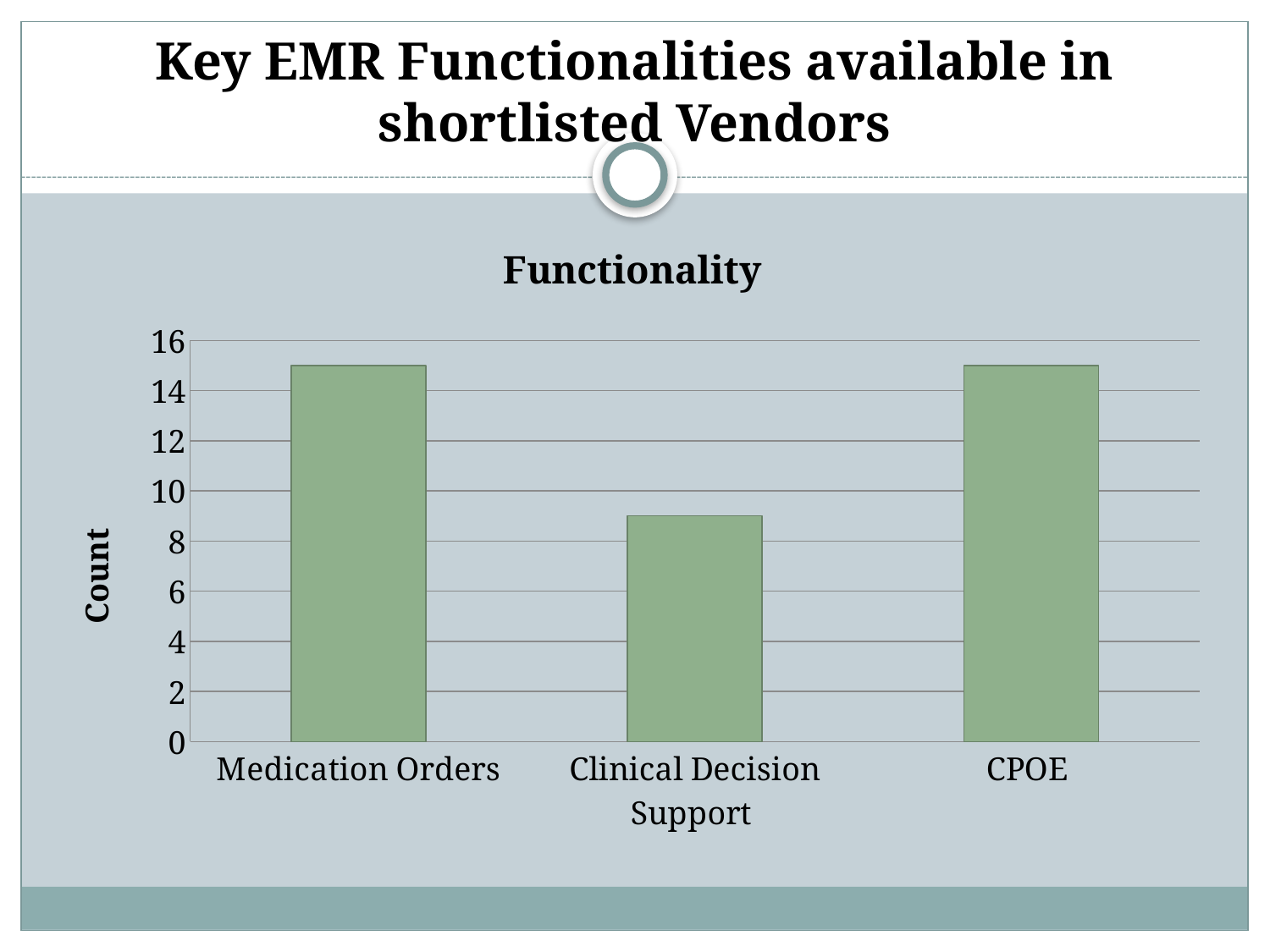
Is the value for Clinical Decision Support greater or less than 8? greater Which has a higher count, CPOE or Clinical Decision Support? CPOE What kind of chart is shown on the slide? bar chart Is the value for CPOE greater or less than 12? greater Is the value for Clinical Decision Support greater or less than 10? less How many categories are plotted on the chart? 3 What is the label on the vertical axis of the chart? Count Which category has the lowest count? Clinical Decision Support Which has a higher count, Medication Orders or Clinical Decision Support? Medication Orders What is the title of the chart? Functionality